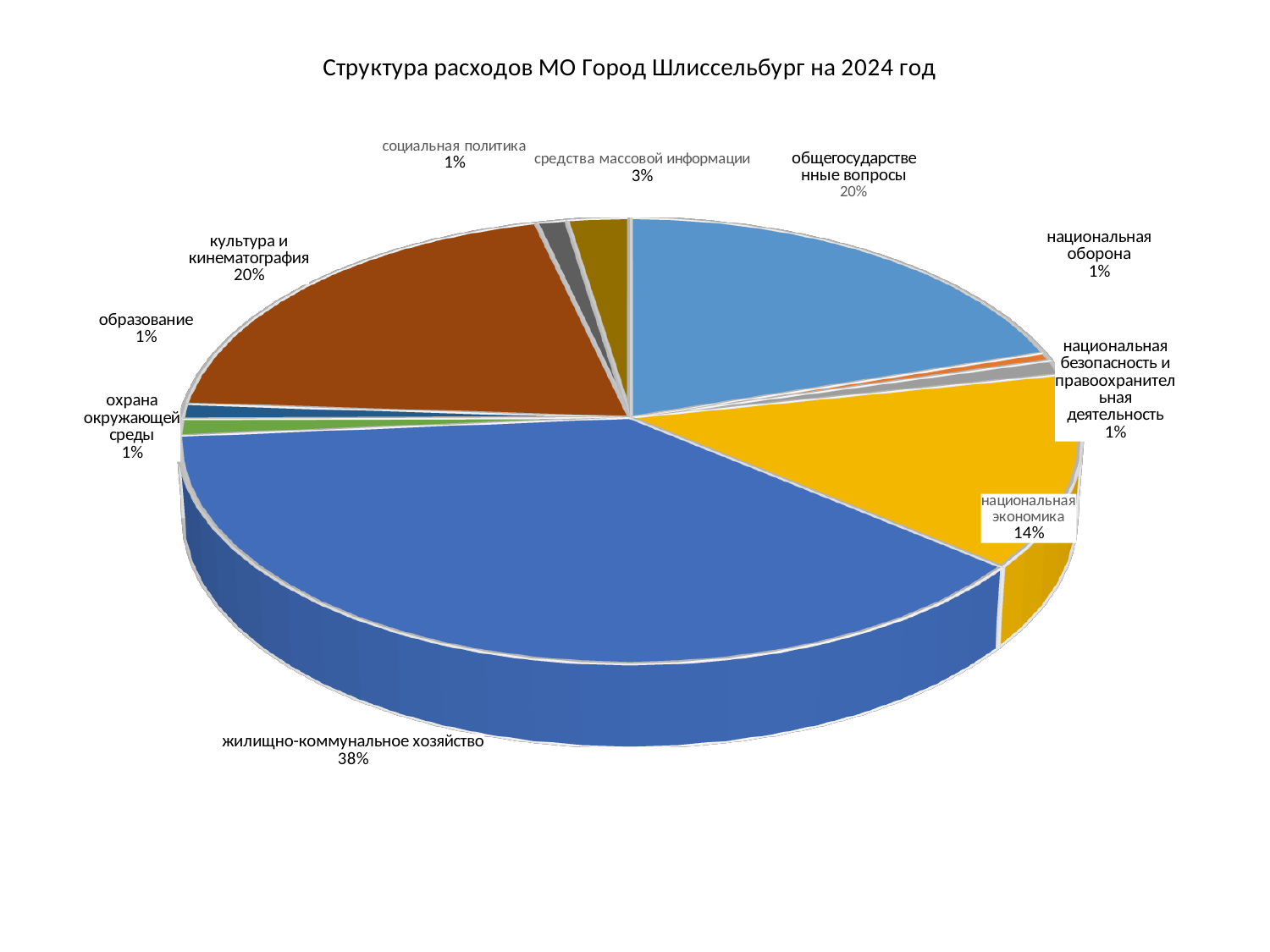
What share of expenses does общегосударственные вопросы account for? 20% What share of expenses does культура и кинематография account for? 20% How many categories are shown in the pie chart? 10 What share of expenses does жилищно-коммунальное хозяйство account for? 38% What is the title of the chart? Структура расходов МО Город Шлиссельбург на 2024 год What kind of chart is shown on the slide? pie chart Which category has the largest share of expenses? жилищно-коммунальное хозяйство Which has the larger share: общегосударственные вопросы or национальная экономика? общегосударственные вопросы By how many percentage points does the share of жилищно-коммунальное хозяйство exceed that of национальная экономика? 24